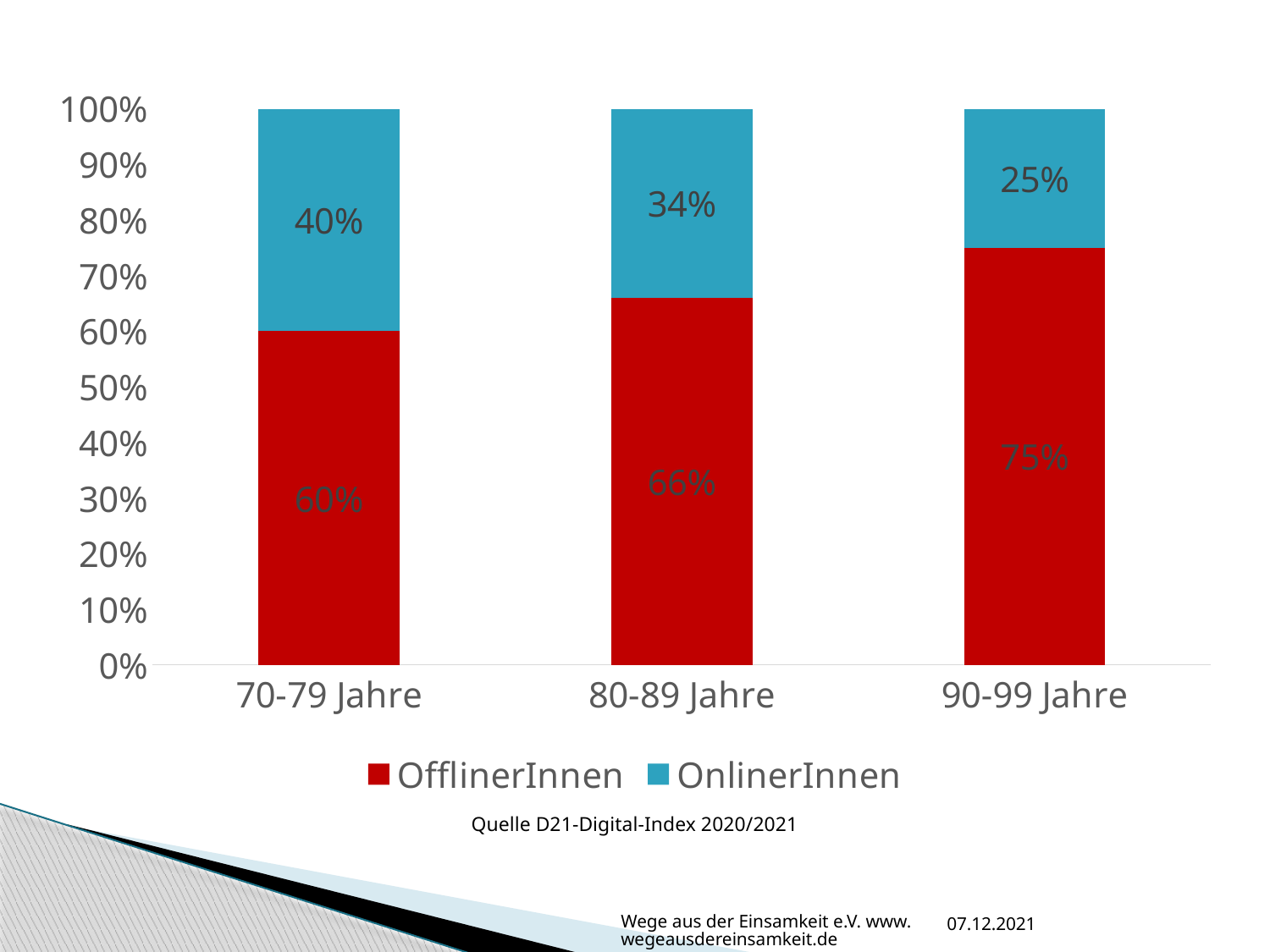
Does the OfflinerInnen share rise or fall from 70-79 Jahre to 90-99 Jahre? Rise How many series does the legend list? 2 What is the total of the stacked bar for 80-89 Jahre? 100% What kind of chart is shown on the slide? Stacked bar chart Which age group has the highest share of OfflinerInnen? 90-99 Jahre What is the difference between the OfflinerInnen share for 90-99 Jahre and for 70-79 Jahre? 15% What is the value for OfflinerInnen in the 90-99 Jahre category? 75% What is the value for OfflinerInnen in the 70-79 Jahre category? 60% What is the value for OnlinerInnen in the 80-89 Jahre category? 34% Which age group has the lowest share of OnlinerInnen? 90-99 Jahre Which is larger: the OnlinerInnen share for 70-79 Jahre or for 80-89 Jahre? 70-79 Jahre How many age categories are shown on the x axis? 3